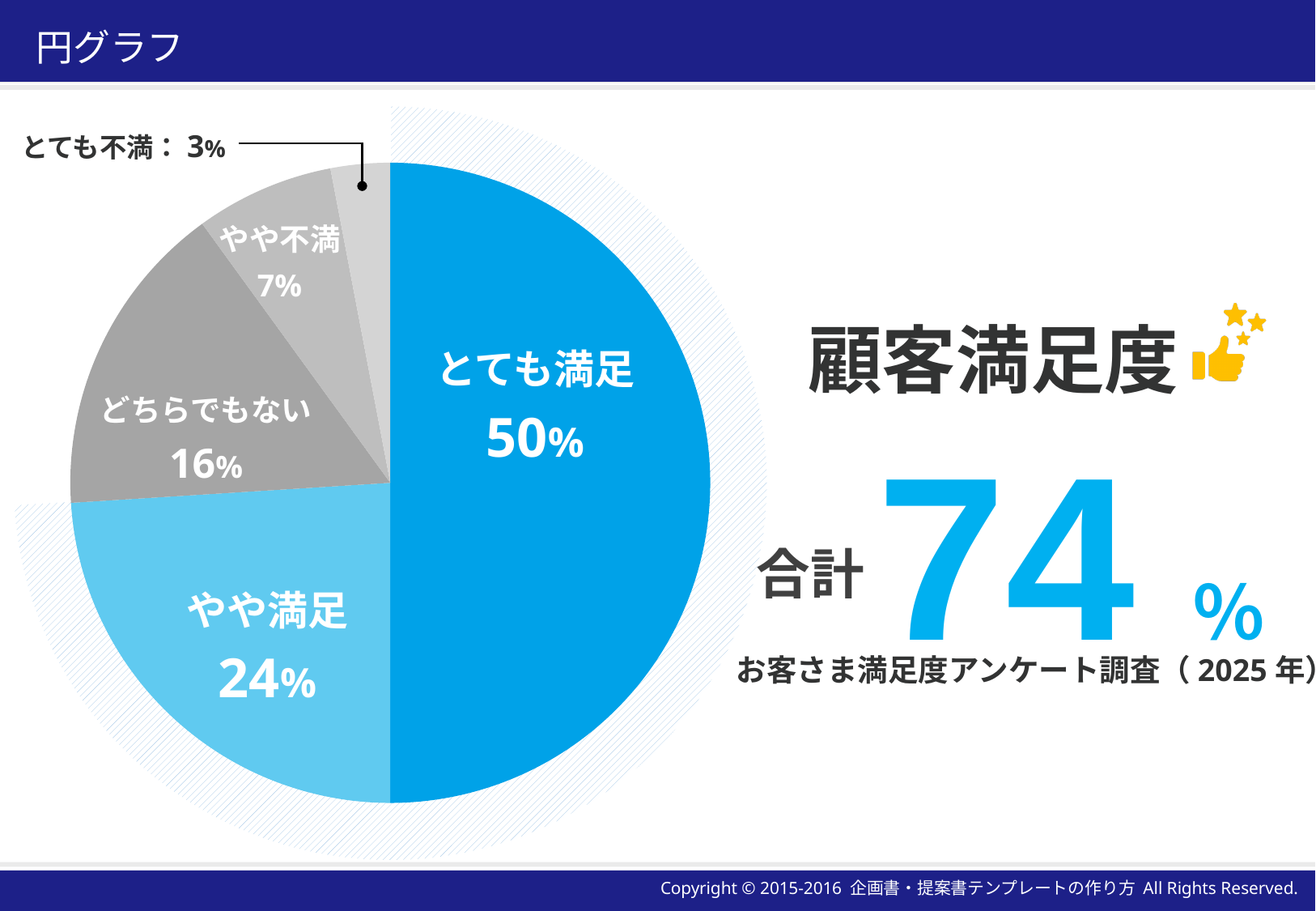
What is the difference between the shares of とても満足 and やや満足? 26% Which slice of the pie is the largest? とても満足 What combined percentage is shown next to 合計 on the right of the slide? 74% How many slices does the pie chart have? 5 What kind of chart is shown on the slide? pie chart Which slice of the pie is the smallest? とても不満 What share of the pie does やや満足 have? 24% Which is larger, the share of どちらでもない or the share of やや不満? どちらでもない What share of the pie does どちらでもない have? 16% What share of the pie does とても不満 have? 3% What share of the pie does とても満足 have? 50% What share of the pie does やや不満 have? 7%